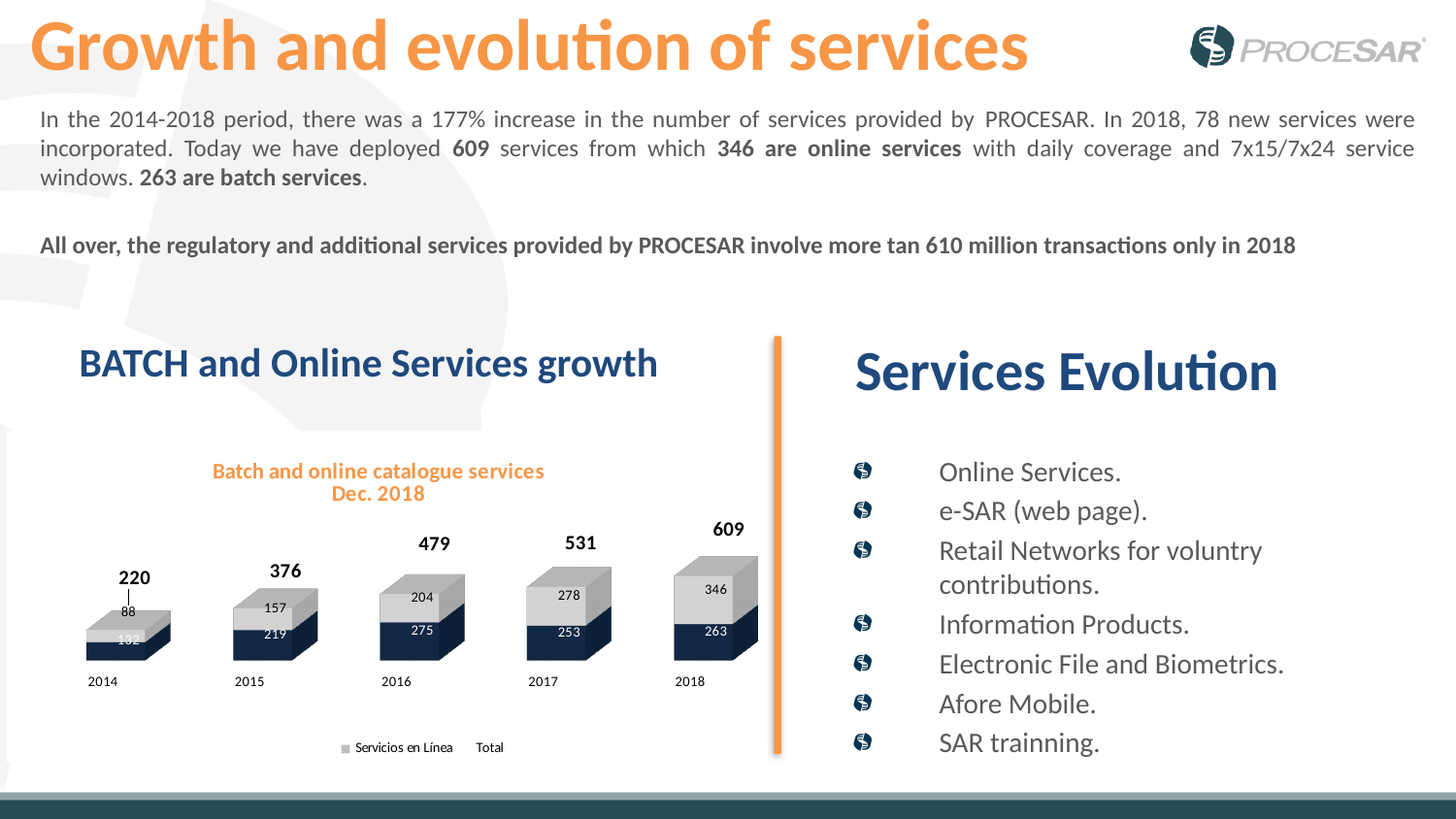
What kind of chart is shown? stacked bar chart What is the total value shown above the 2018 bar? 609 What is the sum of the two segments of the 2015 bar? 376 Which is larger in 2017: the dark blue segment or the light grey segment? the light grey segment (278) How many years are shown on the x axis? 5 Which year has the highest total? 2018 What is the value of the light grey (Servicios en Línea) segment for 2017? 278 What is the title of the chart? Batch and online catalogue services Dec. 2018 Which year has the lowest total? 2014 What is the difference between the totals for 2018 and 2014? 389 Do the totals rise or fall from 2014 to 2018? rise What is the value of the dark blue segment for 2016? 275